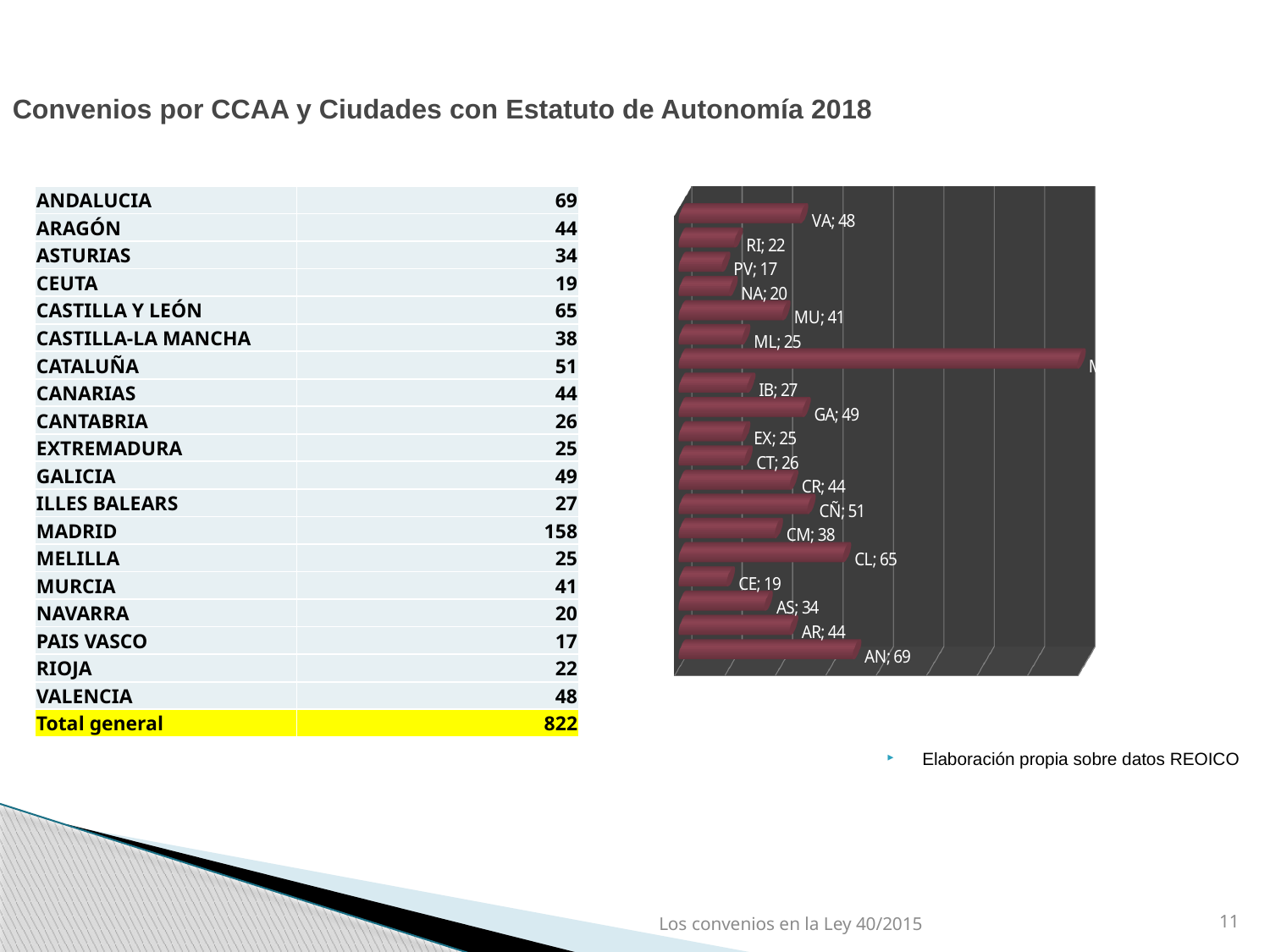
What is the value for CL in the bar chart? 65 How many bars are shown in the bar chart? 19 Do the bars for CR and AR in the bar chart have the same value? Yes, both are 44 Which is larger in the bar chart, the value for RI or the value for NA? RI What is the value for CÑ in the bar chart? 51 What kind of chart is shown on the slide? Bar chart What is the difference between the values for GA and IB in the bar chart? 22 What is the value for VA in the bar chart? 48 What is the difference between the values for AN and CL in the bar chart? 4 What is the value for AN in the bar chart? 69 Which is larger in the bar chart, the value for MU or the value for CM? MU Which category has the lowest value in the bar chart? PV